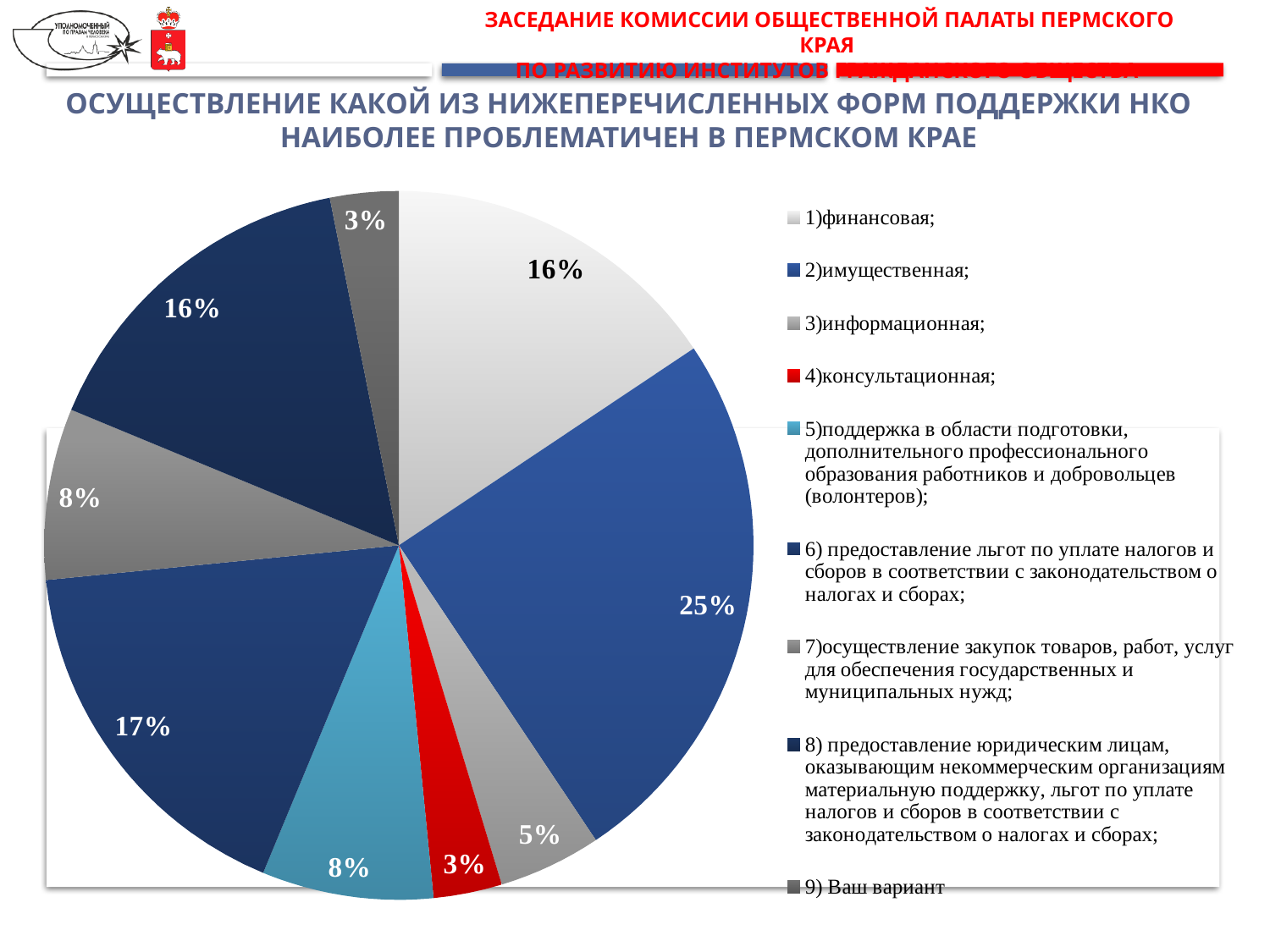
What type of chart is shown on the slide? pie chart Which category has the largest share of the pie? 2)имущественная What is the value shown for "3)информационная"? 5% What colour is the slice for "4)консультационная"? red What is the value shown for "1)финансовая"? 16% What share of the pie does "2)имущественная" have? 25% What is the value shown for "6) предоставление льгот по уплате налогов и сборов в соответствии с законодательством о налогах и сборах"? 17% What is the difference between the share for "2)имущественная" and the share for "1)финансовая"? 9% How many slices does the pie chart have? 9 How many entries does the legend list? 9 What is the value shown for "4)консультационная"? 3% Which is larger: the share for "5)поддержка в области подготовки, дополнительного профессионального образования работников и добровольцев (волонтеров)" or the share for "3)информационная"? 5)поддержка в области подготовки, дополнительного профессионального образования работников и добровольцев (волонтеров)